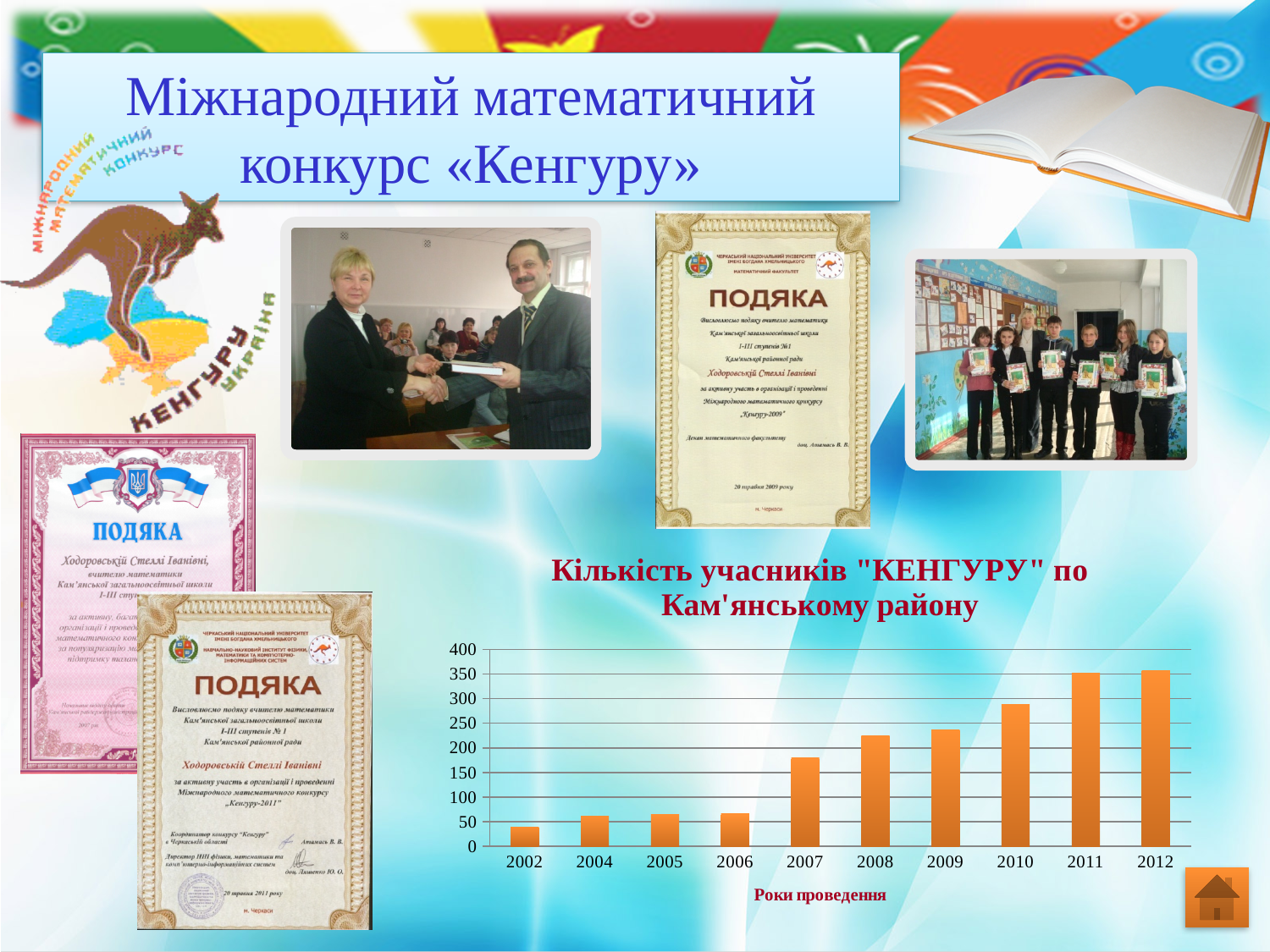
How many years are shown on the x axis of the chart? 10 Is the value for 2007 greater or less than 150? greater Is the value for 2006 greater or less than 100? less What kind of chart is shown on the slide? bar chart Is the value for 2010 greater or less than 250? greater Which year has the lowest number of participants in the chart? 2002 What is the label of the x axis of the chart? Роки проведення Do the values generally rise or fall from 2002 to 2012? rise What is the title of the chart on the slide? Кількість учасників "КЕНГУРУ" по Кам'янському району Which year has the larger value, 2006 or 2007? 2007